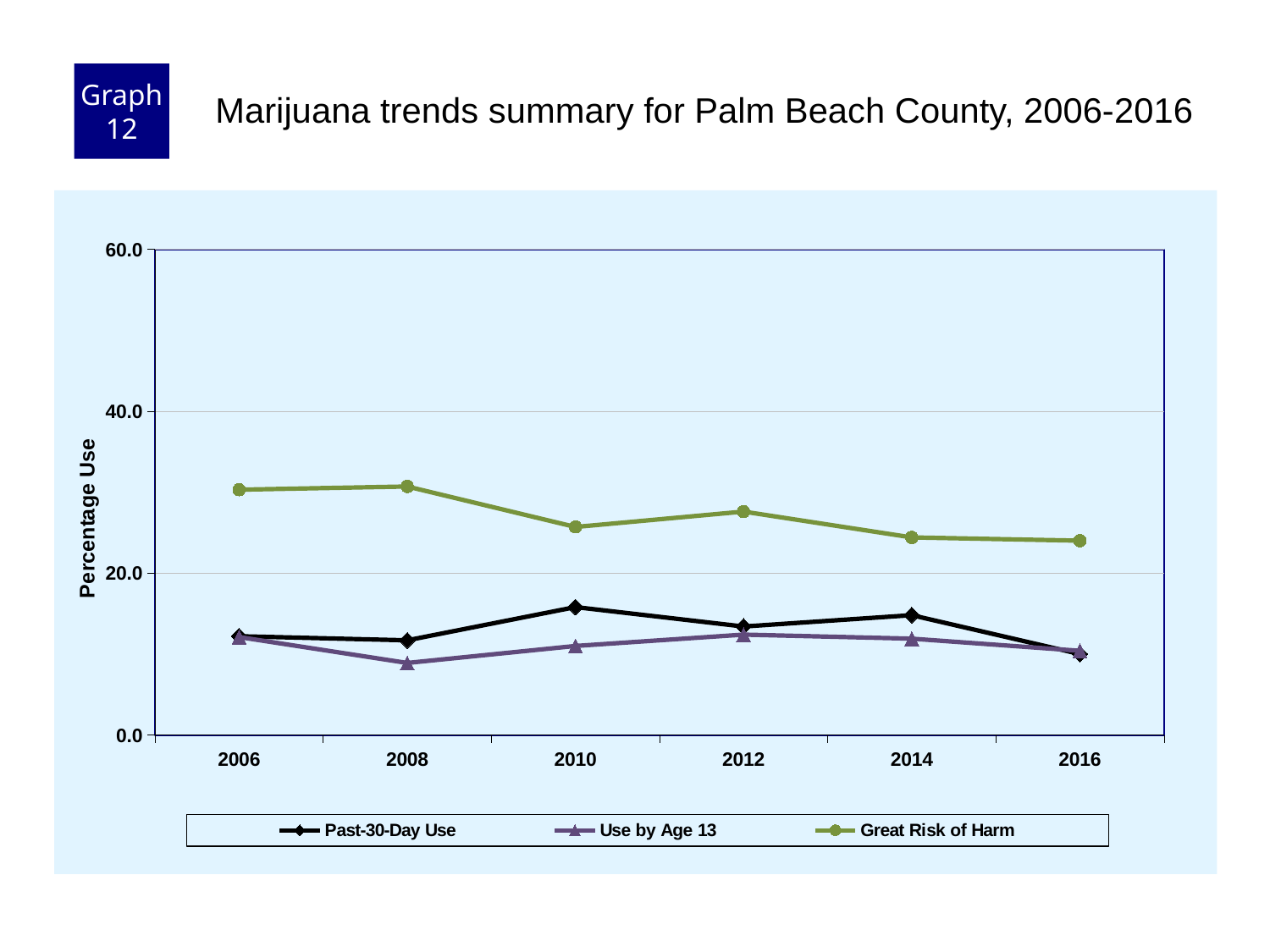
How many series does the legend list? 3 In 2010, which is larger: Past-30-Day Use or Use by Age 13? Past-30-Day Use How many years are plotted along the x axis? 6 Is the value for Great Risk of Harm in 2006 greater or less than 20.0? greater In which year is Past-30-Day Use at its lowest? 2016 Does Great Risk of Harm rise or fall overall from 2006 to 2016? fall What kind of chart is shown on the slide? line chart Is the value for Great Risk of Harm in 2008 greater or less than 40.0? less In 2010, which is larger: Great Risk of Harm or Past-30-Day Use? Great Risk of Harm What is the label on the y axis? Percentage Use In which year is Use by Age 13 at its lowest? 2008 Is the value for Past-30-Day Use in 2010 greater or less than 20.0? less